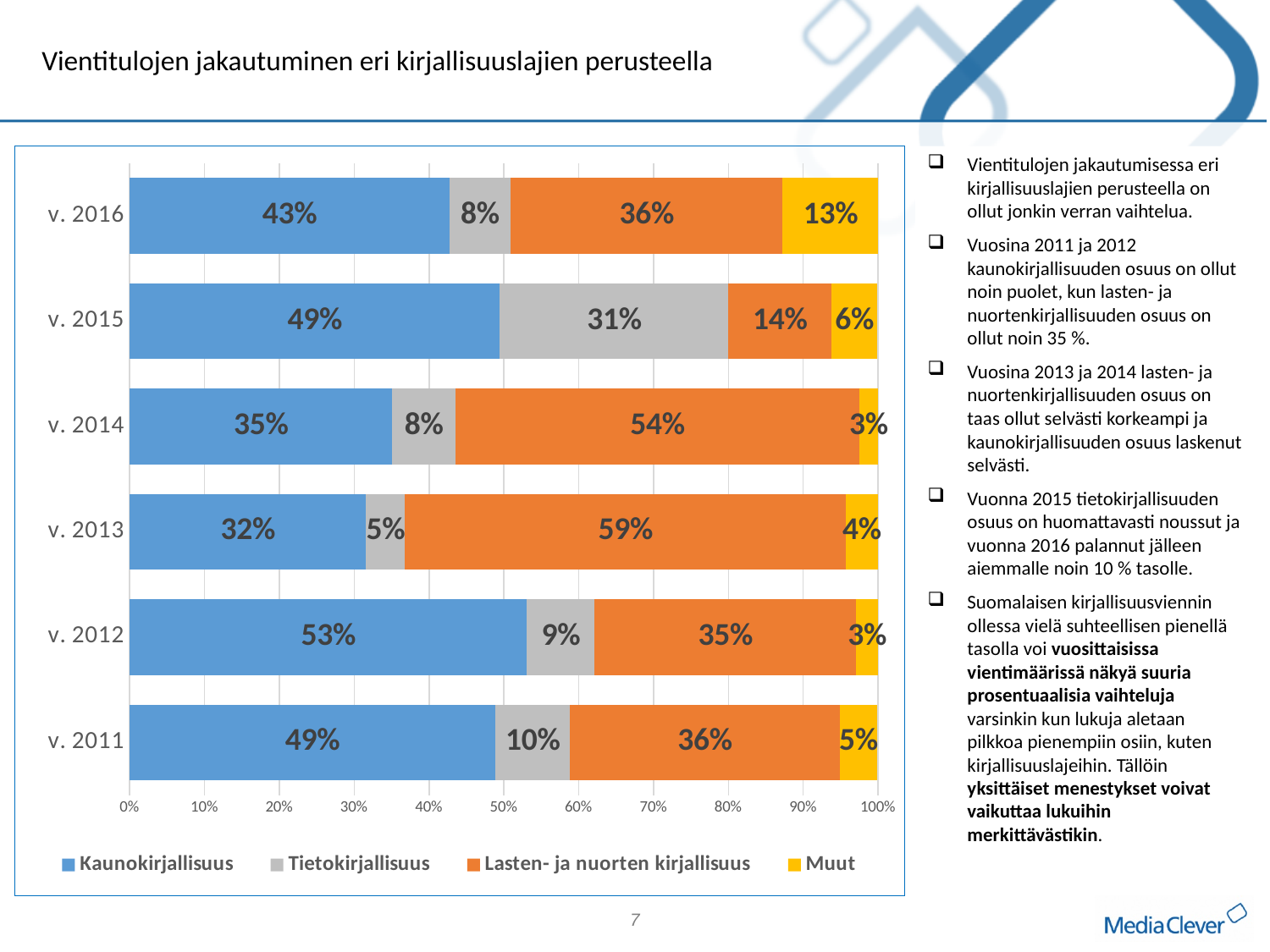
In which year is the Lasten- ja nuorten kirjallisuus share the lowest? v. 2015 What is the title of the chart? Vientitulojen jakautuminen eri kirjallisuuslajien perusteella What kind of chart is shown on the slide? Stacked bar chart In which year is the Kaunokirjallisuus share the highest? v. 2012 How many years (categories) are shown on the chart? 6 What is the Lasten- ja nuorten kirjallisuus share for v. 2013? 59% What is the Kaunokirjallisuus share for v. 2016? 43% What is the Tietokirjallisuus share for v. 2015? 31% What is the Muut share for v. 2011? 5% How many series does the legend list? 4 What is the difference between the Lasten- ja nuorten kirjallisuus share in v. 2014 and in v. 2012? 19% Which is larger: the Muut share in v. 2016 or in v. 2015? v. 2016